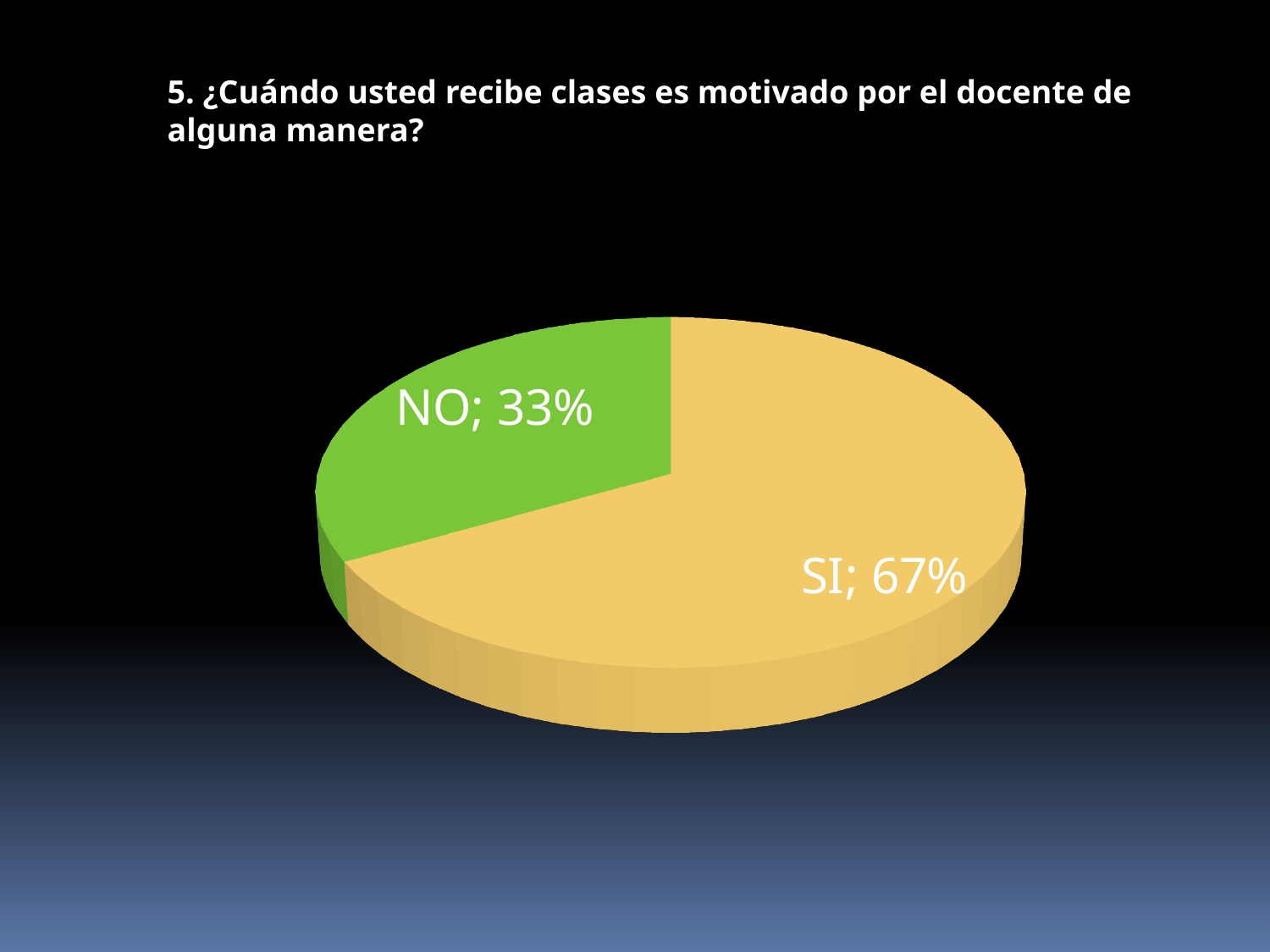
What share of the pie does the NO slice represent? 33% What is the difference in percentage points between the SI and NO slices? 34 What percentage of respondents answered SI? 67% What percentage of respondents answered NO? 33% What colour is the SI slice? Yellow Which response has the smallest share of the pie? NO What kind of chart is shown on the slide? Pie chart Which response has the largest share of the pie? SI What colour is the NO slice? Green Which slice is larger, SI or NO? SI How many slices does the pie chart have? 2